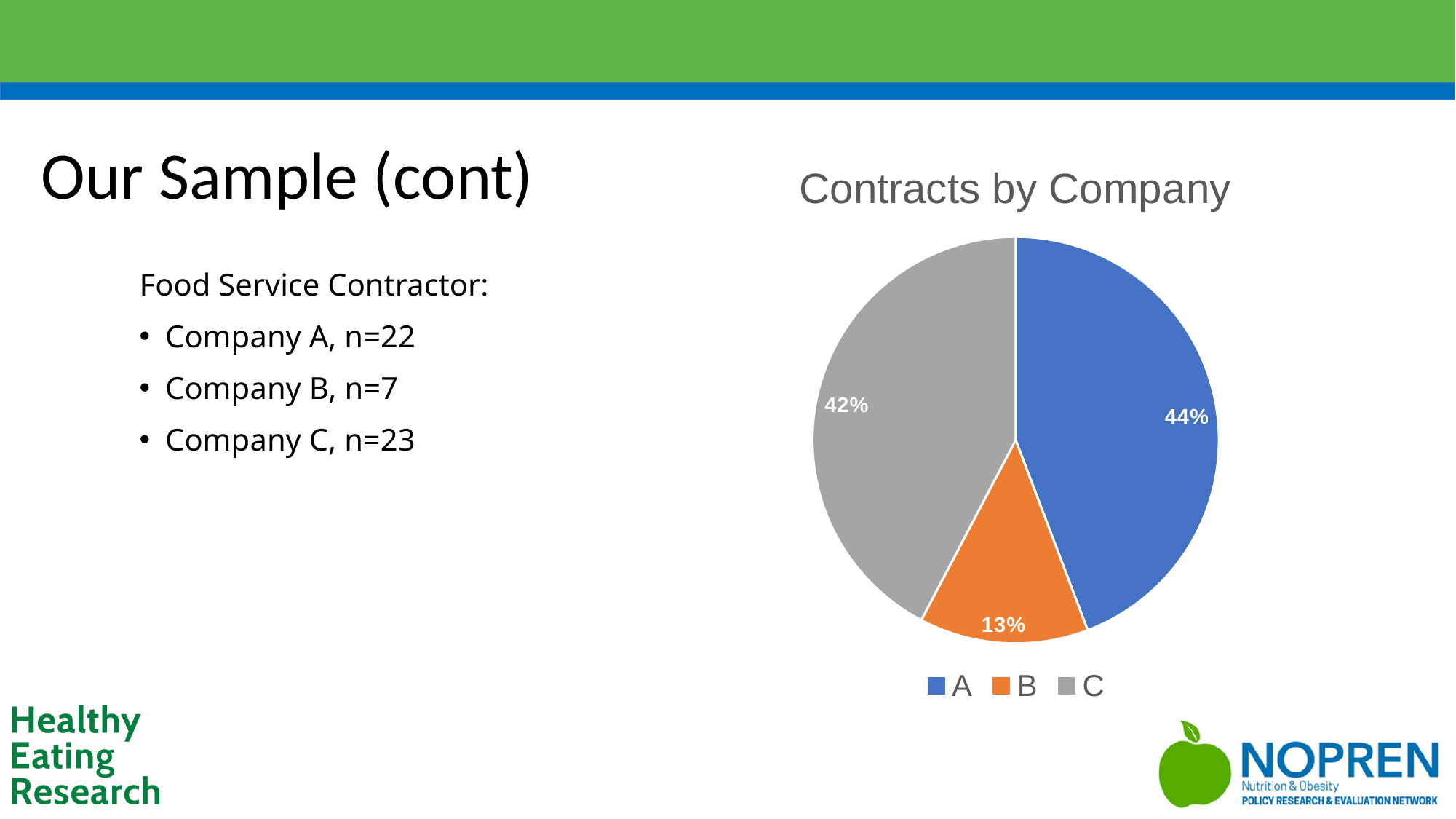
How many entries does the legend of the pie chart list? 3 What is the difference in percentage points between Company A's and Company B's slices? 31% Which company has the smallest slice of the pie chart? B Which company has the largest slice of the pie chart? A What kind of chart is shown on the slide? pie chart What share of contracts does Company A hold in the pie chart? 44% How many slices does the pie chart have? 3 What share of contracts does Company C hold in the pie chart? 42% What colour is the slice for Company B in the pie chart? orange What is the title of the pie chart? Contracts by Company What share of contracts does Company B hold in the pie chart? 13% Which slice is larger, Company B or Company C? C